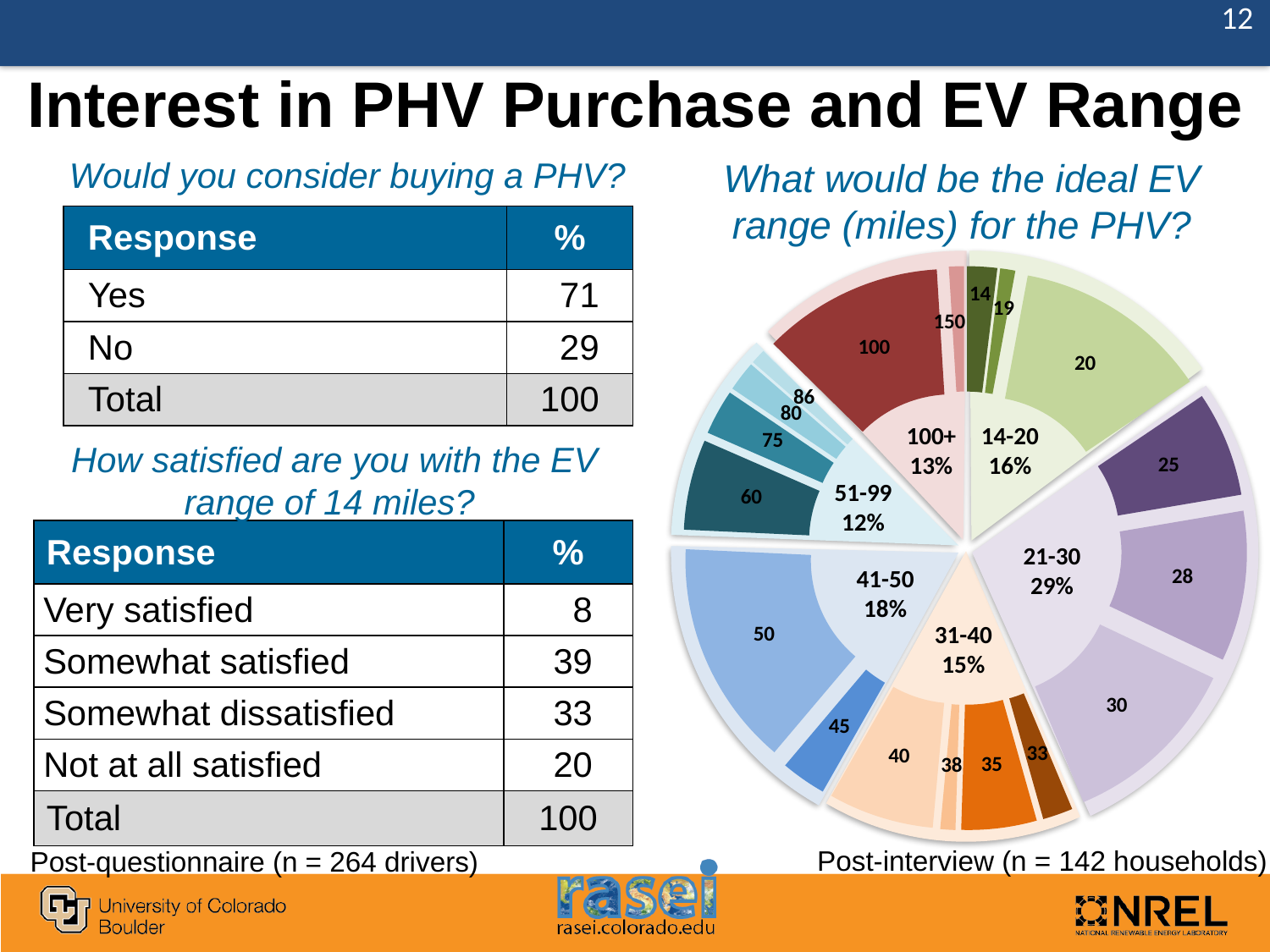
In the ideal EV range chart, what share of households chose a range of 31-40 miles? 15% In the ideal EV range chart, which has the larger share: 31-40 miles or 41-50 miles? 41-50 Which range category has the largest share in the ideal EV range chart? 21-30 In the ideal EV range chart, what percentage of households chose a range of 100+ miles? 13% How many range categories are shown in the inner ring of the ideal EV range chart? 6 In the ideal EV range chart, what percentage of households chose a range of 41-50 miles? 18% What kind of chart is used to show the ideal EV range for the PHV? doughnut chart In the ideal EV range chart, which individual mile values are shown in the outer ring for the 21-30 category? 25, 28, 30 What is the title of the pie chart on the slide? What would be the ideal EV range (miles) for the PHV? In the ideal EV range chart, how many percentage points larger is the 21-30 share than the 14-20 share? 13 Which range category has the smallest share in the ideal EV range chart? 51-99 In the ideal EV range chart, what percentage of households chose a range of 21-30 miles? 29%